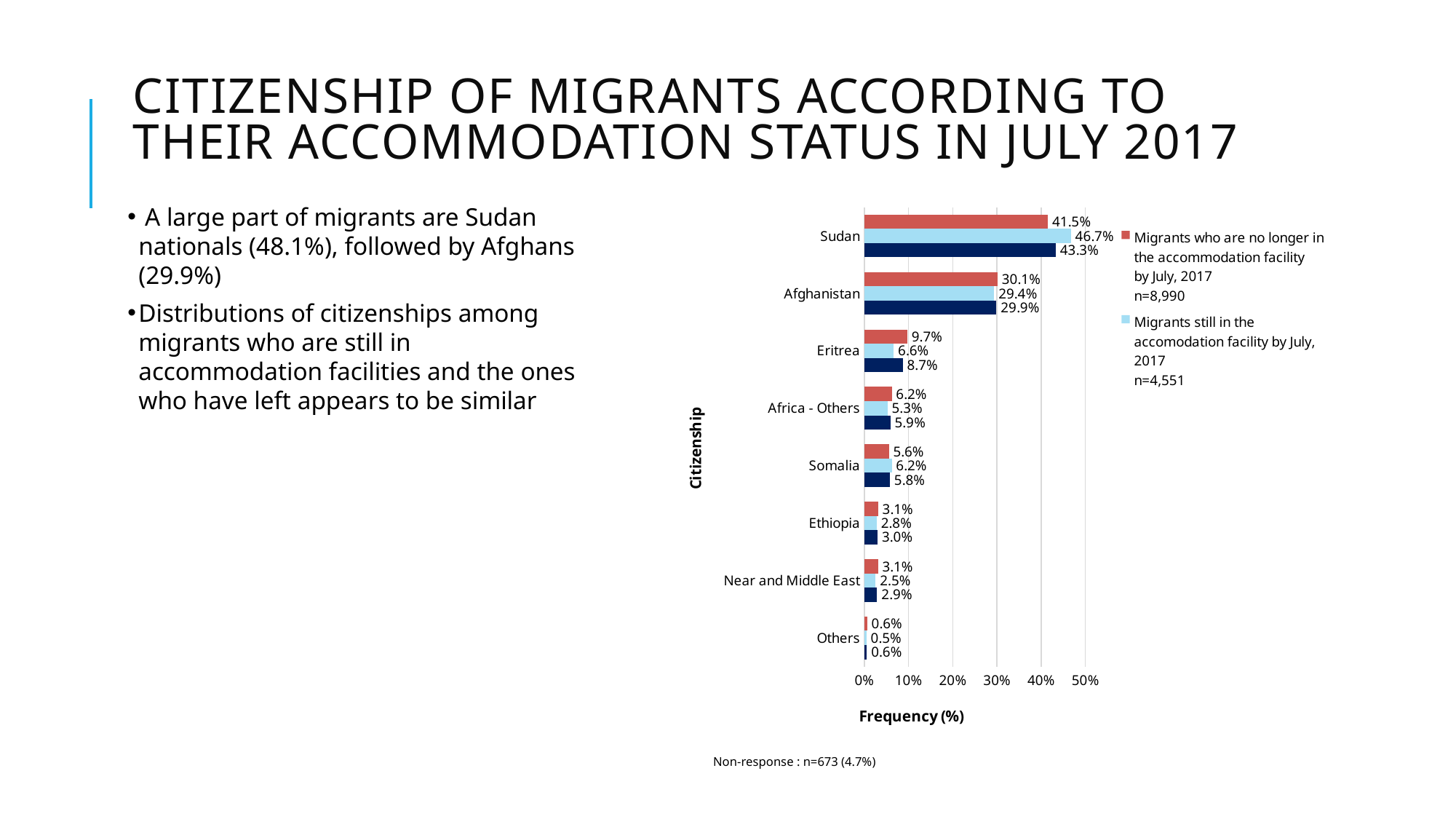
In the 'Migrants who are no longer in the accommodation facility by July, 2017' series, which is larger: Eritrea or Somalia? Eritrea Which citizenship has the lowest value in the 'Migrants still in the accomodation facility by July, 2017' series? Others What kind of chart is shown on the slide? bar chart What is the label of the x axis of the chart? Frequency (%) How many series does the chart's legend list? 2 Is the value for Sudan in the 'Migrants still in the accomodation facility by July, 2017' series greater or less than 40%? greater What is the value for Eritrea in the 'Migrants still in the accomodation facility by July, 2017' series? 6.6% What is the difference between the Sudan and Afghanistan values in the 'Migrants still in the accomodation facility by July, 2017' series? 17.3% What is the value for Sudan in the 'Migrants still in the accomodation facility by July, 2017' series? 46.7% Which citizenship has the highest value in the 'Migrants who are no longer in the accommodation facility by July, 2017' series? Sudan What is the value for Afghanistan in the 'Migrants who are no longer in the accommodation facility by July, 2017' series? 30.1% How many citizenship categories are shown on the chart? 8